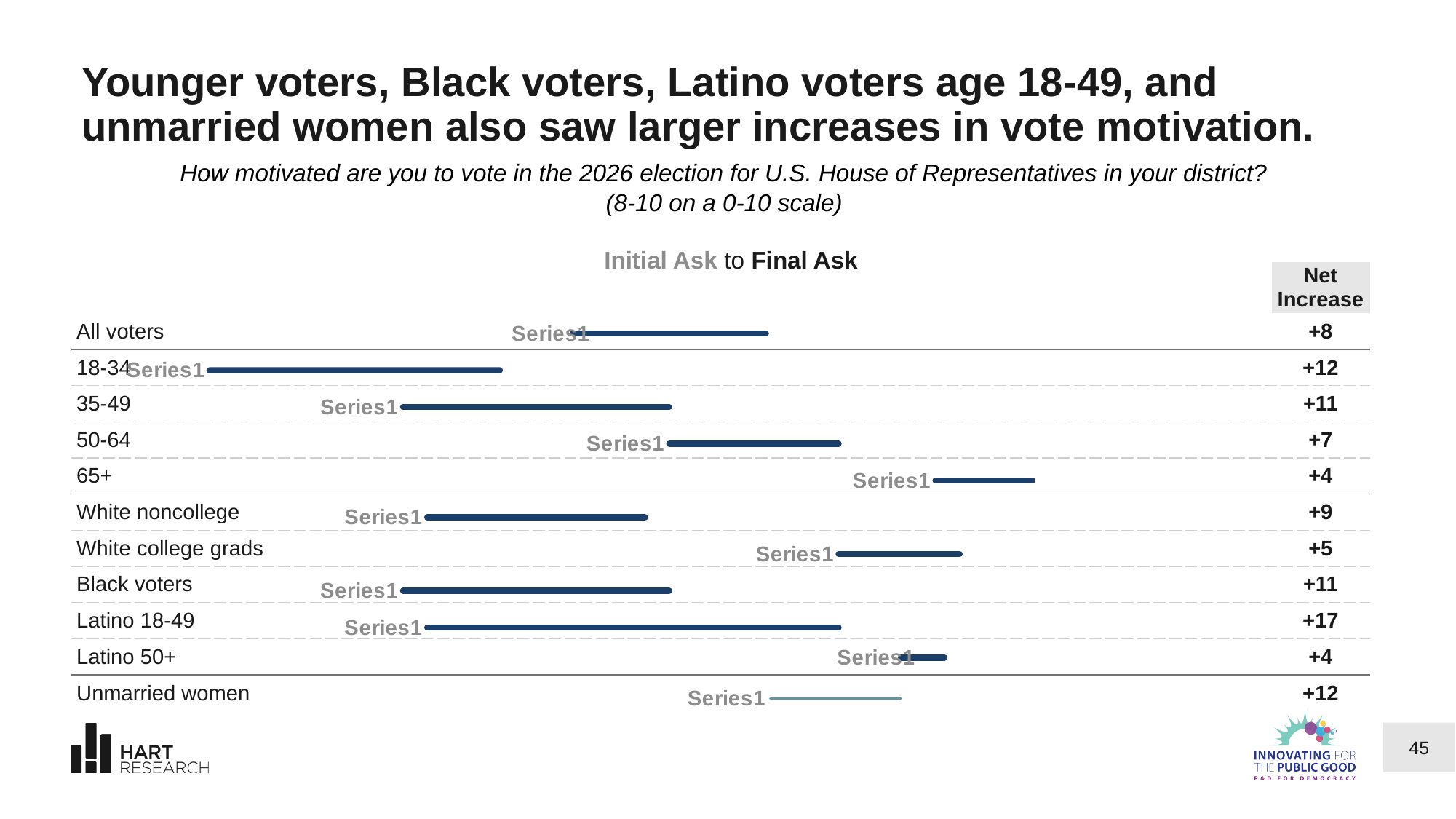
How much larger is the Net Increase for 18-34 than for 65+? 8 Which two groups share the smallest Net Increase of +4? 65+ and Latino 50+ Which group has the largest Net Increase? Latino 18-49 What is the Net Increase shown for 50-64? +7 Which has a larger Net Increase, Black voters or White college grads? Black voters What is the Net Increase shown for White college grads? +5 How many voter groups are listed in the chart? 11 What is the Net Increase shown for All voters? +8 What is the Net Increase shown for Latino 18-49? +17 What is the heading of the column of values on the right side of the chart? Net Increase How much larger is the Net Increase for Latino 18-49 than for Latino 50+? 13 What is the Net Increase shown for Unmarried women? +12